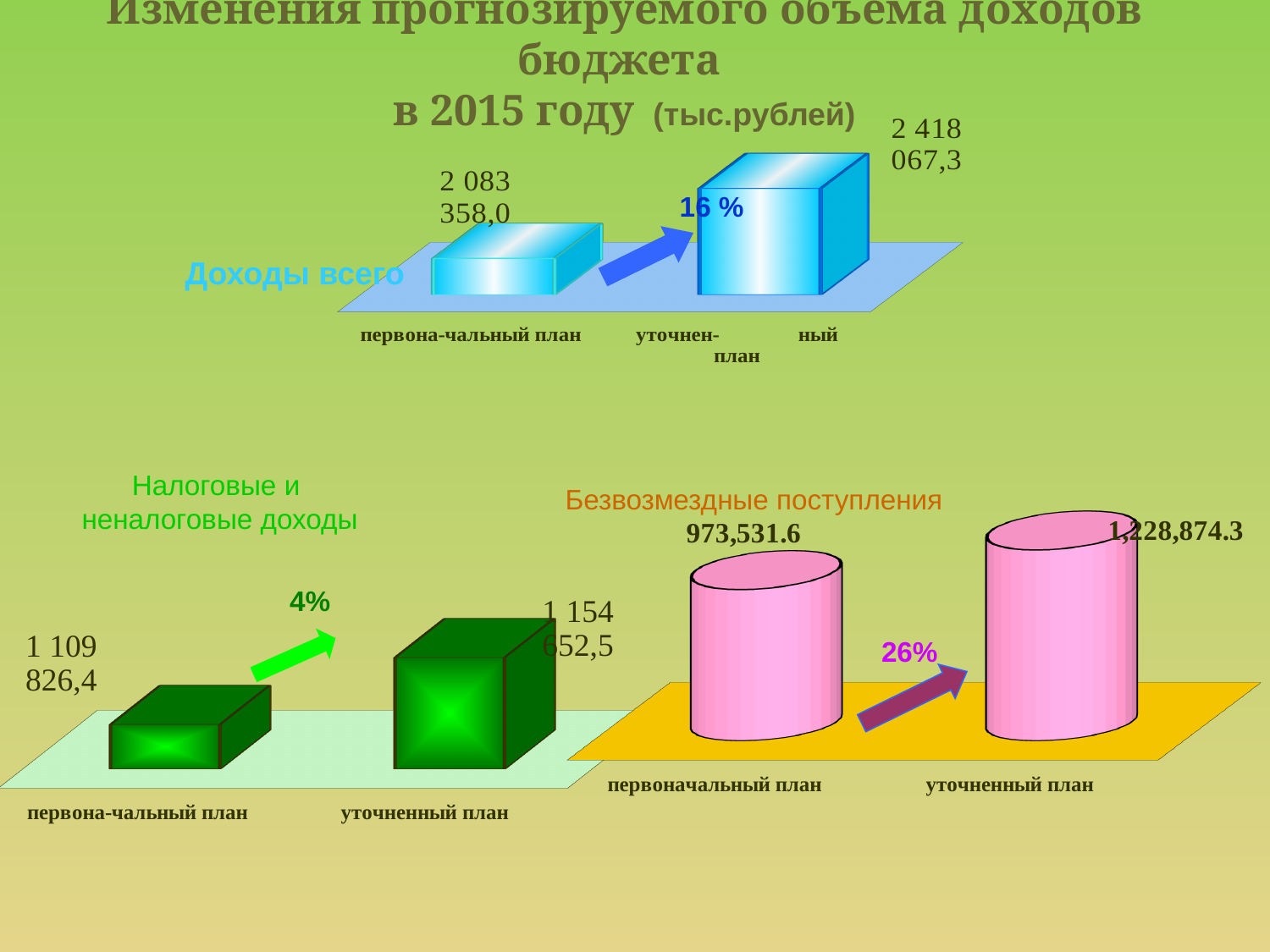
In the 'Налоговые и неналоговые доходы' chart, what is the value for уточненный план? 1 154 652,5 In the 'Безвозмездные поступления' chart, what is the value for первоначальный план? 973,531.6 In the 'Безвозмездные поступления' chart, which category has the lower value? первоначальный план In the 'Доходы всего' chart, what is the value for уточненный план? 2 418 067,3 In the 'Безвозмездные поступления' chart, what is the value for уточненный план? 1,228,874.3 In the 'Налоговые и неналоговые доходы' chart, what is the value for первоначальный план? 1 109 826,4 How many categories does the 'Налоговые и неналоговые доходы' chart show? 2 In the 'Доходы всего' chart, what is the difference between уточненный план and первоначальный план? 334 709,3 In the 'Безвозмездные поступления' chart, what is the difference between уточненный план and первоначальный план? 255,342.7 In the 'Доходы всего' chart, what is the value for первоначальный план? 2 083 358,0 What percentage change is shown by the arrow in the 'Безвозмездные поступления' chart? 26% In the 'Доходы всего' chart, which category has the higher value? уточненный план